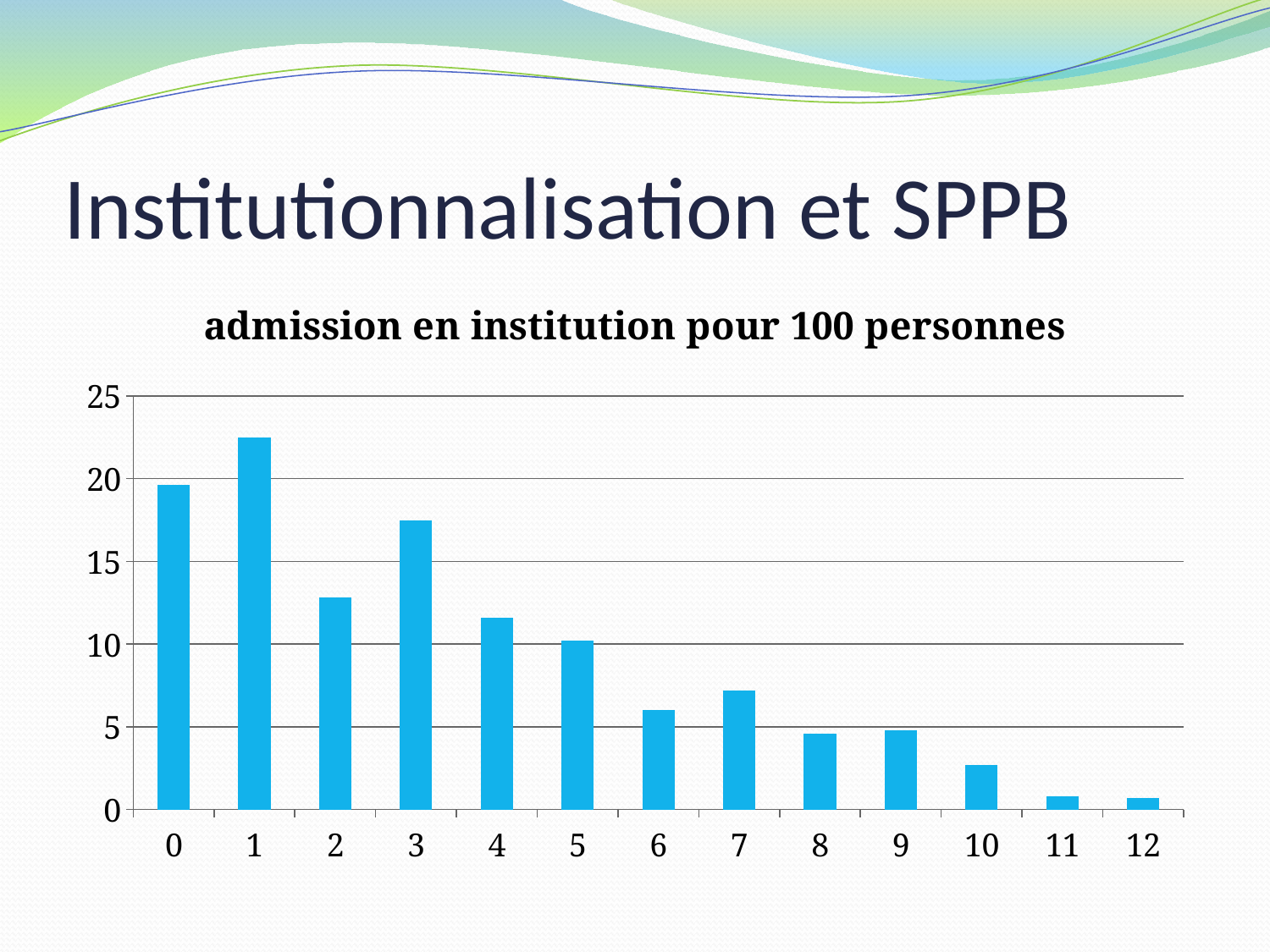
Is the value for category 3 greater or less than 15? greater What kind of chart is shown on the slide? bar chart Which is larger, the value for category 2 or the value for category 3? 3 Is the value for category 10 greater or less than 5? less Overall, do the values rise or fall as the categories go from 0 to 12? fall How many categories are shown on the x axis of the chart? 13 Is the value for category 1 greater or less than 20? greater Which category has the highest value in the chart? 1 Which is larger, the value for category 6 or the value for category 7? 7 What is the title of the chart? admission en institution pour 100 personnes